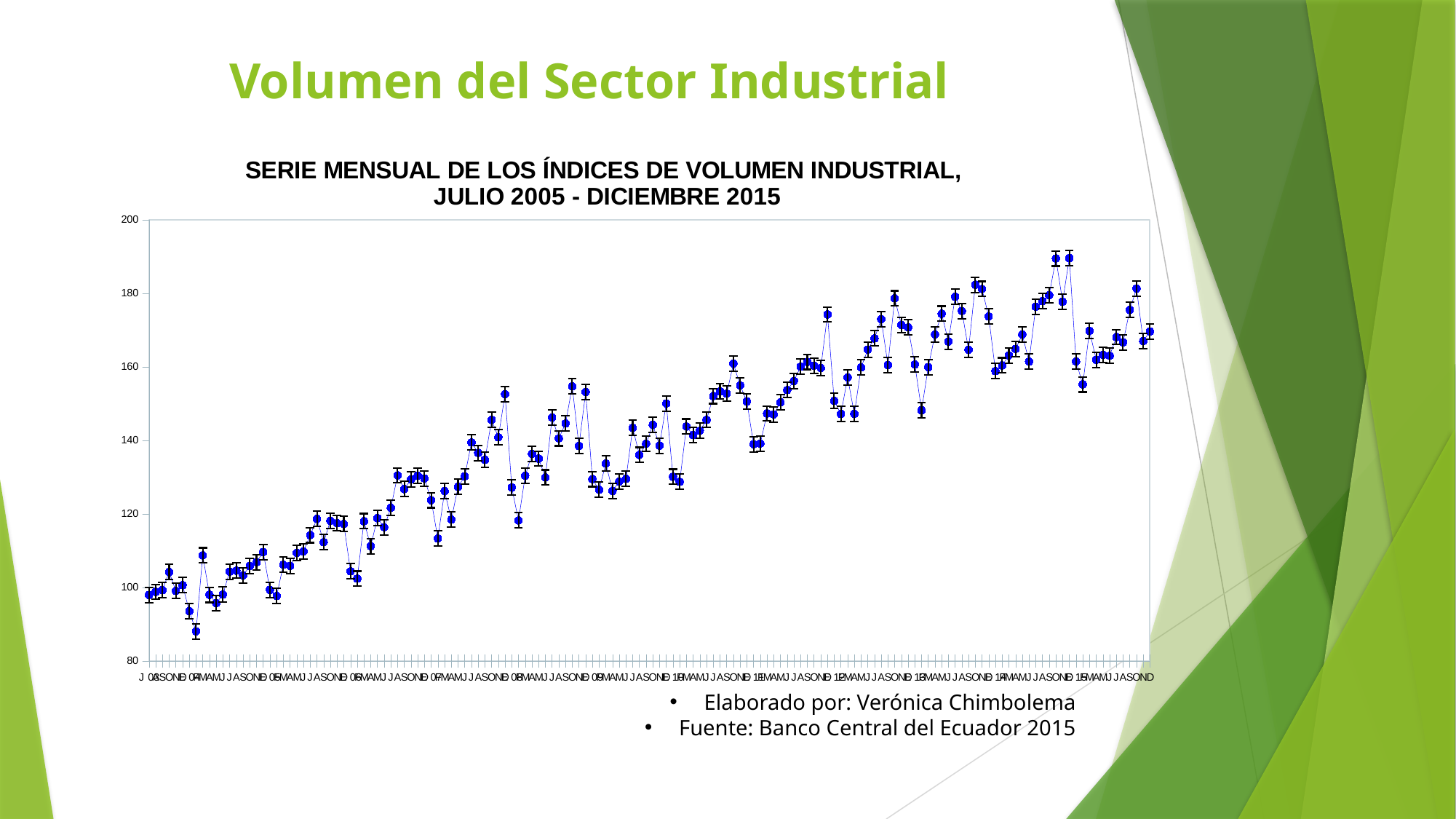
Is the first plotted value (July 2005) greater or less than 120? less What is the highest value shown on the y axis? 200 Is the highest point in the series greater or less than 180? greater What kind of chart is shown on the slide? line chart Does any plotted value exceed 200? no Do the plotted values generally rise or fall from July 2005 to December 2015? rise What is the title of the chart? SERIE MENSUAL DE LOS ÍNDICES DE VOLUMEN INDUSTRIAL, JULIO 2005 - DICIEMBRE 2015